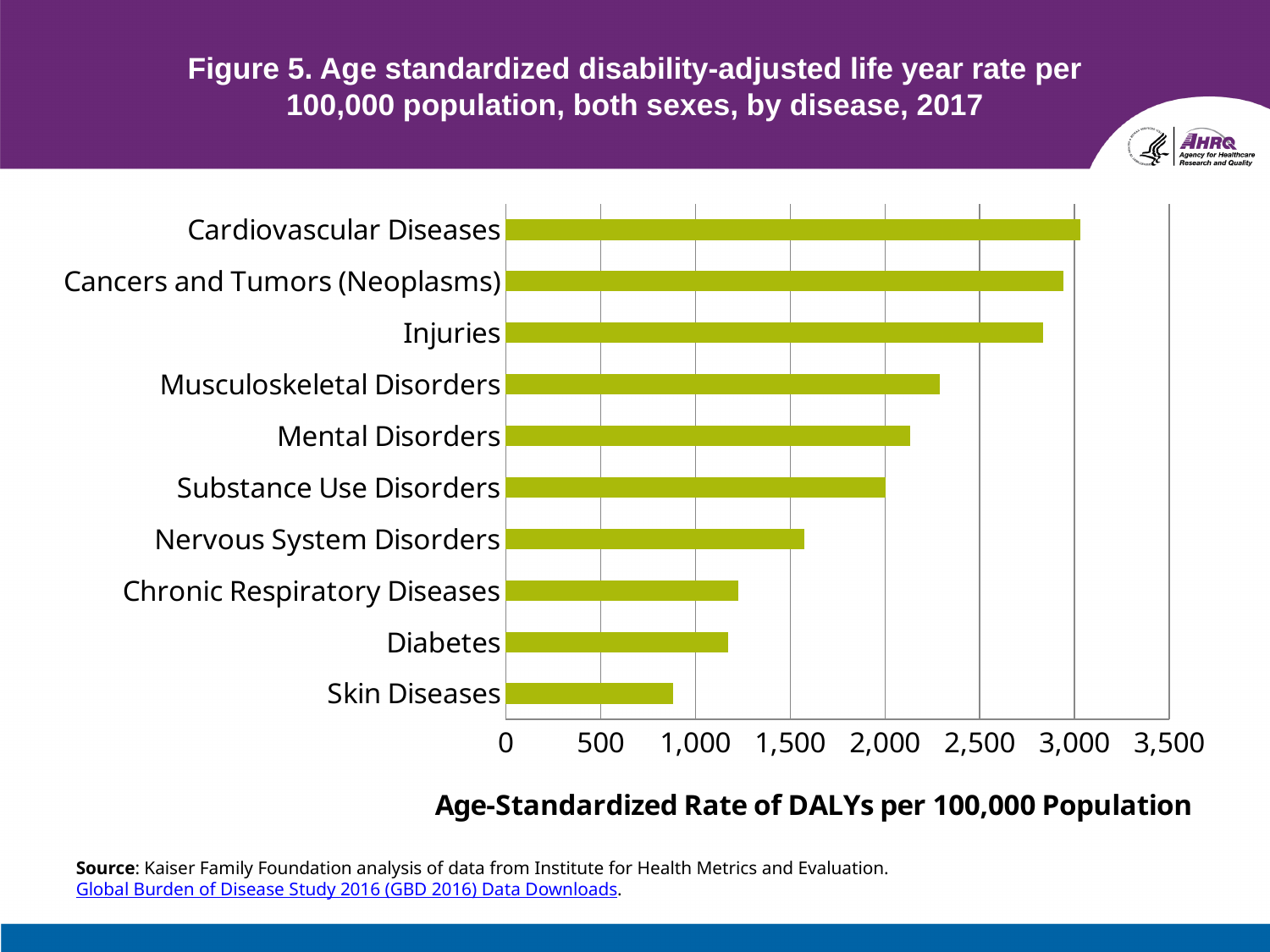
Which has a higher DALY rate, Mental Disorders or Substance Use Disorders? Mental Disorders Is the value for Musculoskeletal Disorders greater or less than 2,000? greater Which disease category has the highest age-standardized DALY rate? Cardiovascular Diseases Is the value for Nervous System Disorders greater or less than 1,500? greater Which has a higher DALY rate, Injuries or Musculoskeletal Disorders? Injuries Is the value for Cardiovascular Diseases greater or less than 2,500? greater What is the title of the horizontal axis of the chart? Age-Standardized Rate of DALYs per 100,000 Population What kind of chart is shown on the slide? bar chart How many diseases or disorders are plotted in the chart? 10 Which disease category has the lowest age-standardized DALY rate? Skin Diseases